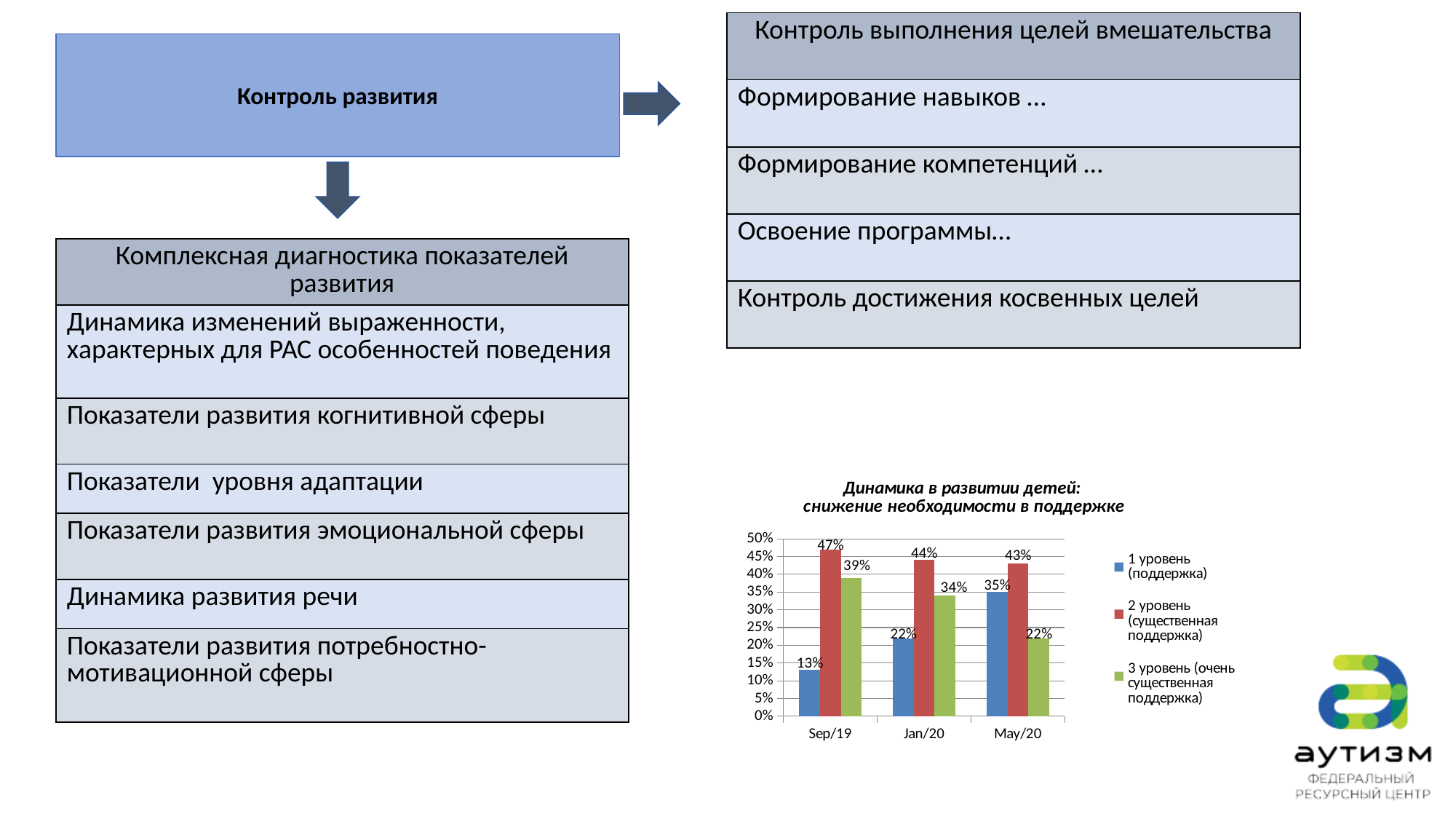
What is the value for '1 уровень (поддержка)' at Sep/19? 13% What is the title of the chart? Динамика в развитии детей: снижение необходимости в поддержке At which date is the value for '1 уровень (поддержка)' highest? May/20 Which is larger at Sep/19: '2 уровень (существенная поддержка)' or '3 уровень (очень существенная поддержка)'? 2 уровень (существенная поддержка) What type of chart is shown on the slide? bar chart What is the value for '2 уровень (существенная поддержка)' at Jan/20? 44% At which date is the value for '3 уровень (очень существенная поддержка)' lowest? May/20 What is the value for '3 уровень (очень существенная поддержка)' at May/20? 22% How many series does the legend list? 3 How many dates are shown on the x axis? 3 Does the value for '3 уровень (очень существенная поддержка)' rise or fall from Sep/19 to May/20? fall What is the difference between the '1 уровень (поддержка)' values at May/20 and Sep/19? 22%